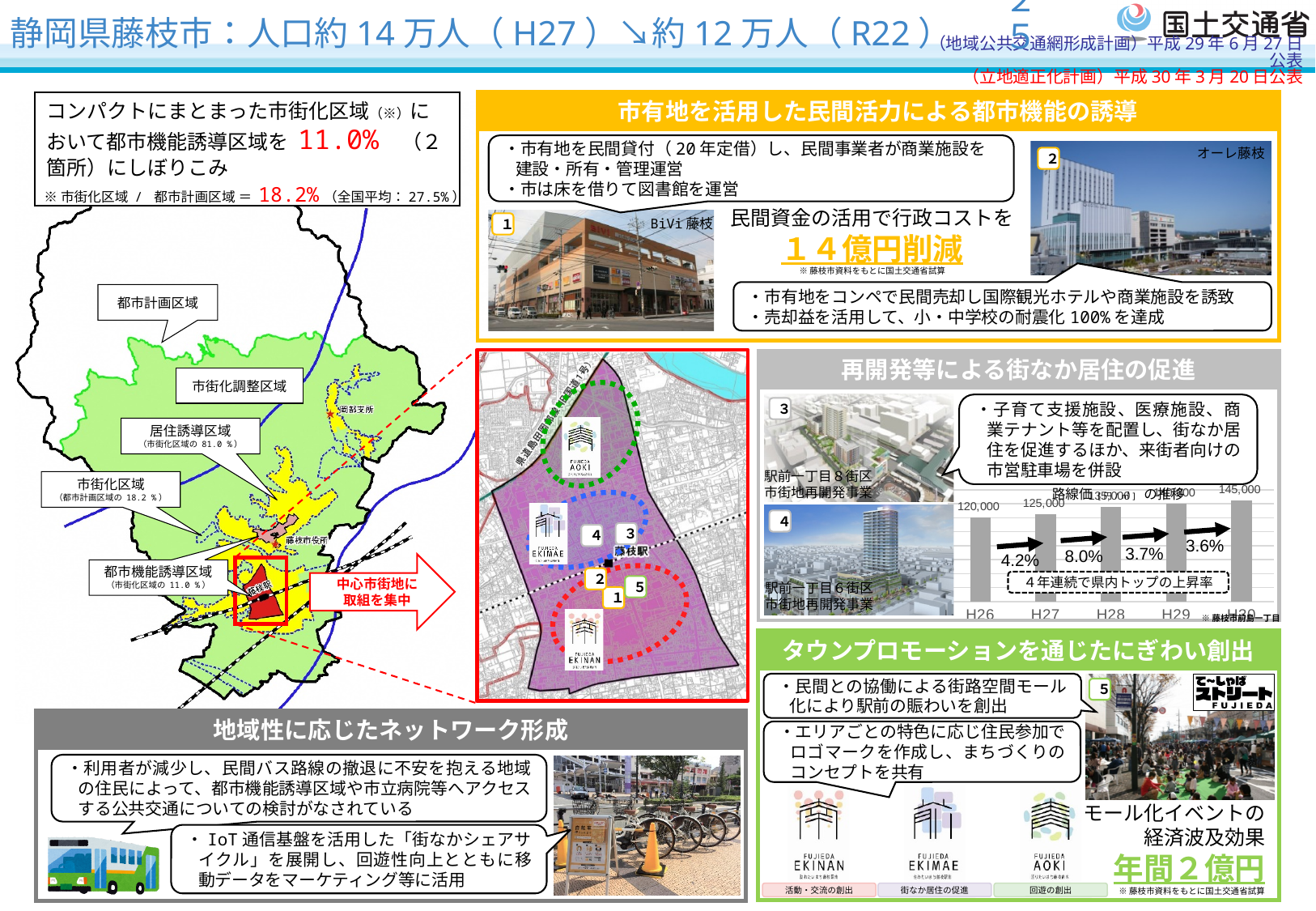
In the 路線価の推移 bar chart, what is the value for H26? 120,000 In the 路線価の推移 bar chart, do the values rise or fall from H26 to H30? rise In the 路線価の推移 bar chart, which is larger, the value for H27 or the value for H30? H30 In the 路線価の推移 bar chart, what is the difference between the H30 value and the H26 value? 25,000 In the 路線価の推移 bar chart, which year has the lowest value? H26 How many years (categories) are shown on the x axis of the 路線価の推移 bar chart? 5 In the 路線価の推移 bar chart, what is the difference between the H27 value and the H26 value? 5,000 In the 路線価の推移 bar chart, what percentage label is shown on the arrow between H27 and H28? 8.0% In the 路線価の推移 bar chart, what is the value for H27? 125,000 In the 路線価の推移 bar chart, which year has the highest value? H30 In the 路線価の推移 bar chart, what is the value for H30? 145,000 What kind of chart is the 路線価の推移 chart on the right side of the slide? bar chart